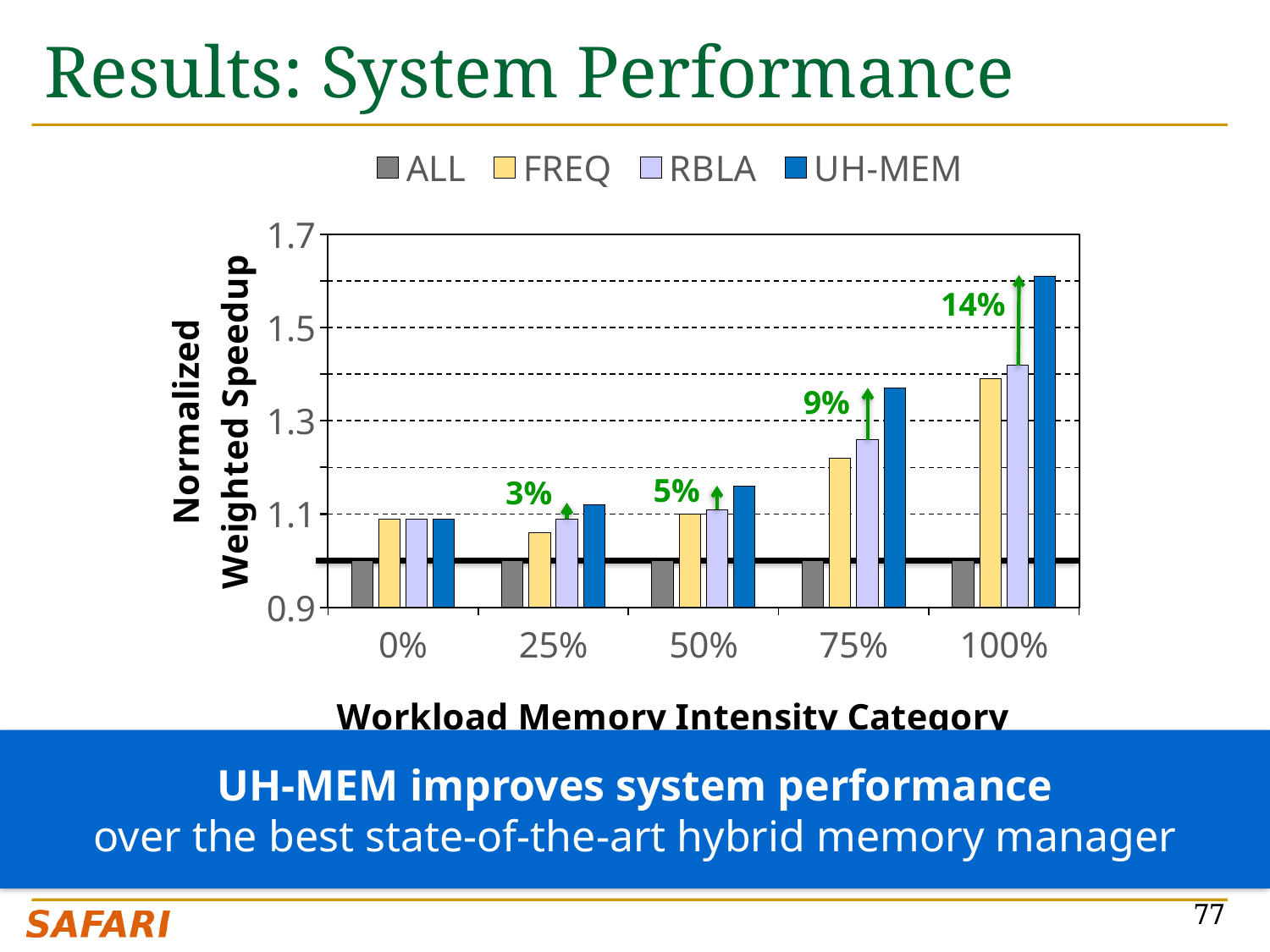
Is the UH-MEM value for the 0% category greater or less than 1.3? less How many series does the legend list? 4 Is the FREQ value for the 75% category greater or less than 1.3? less How many workload memory intensity categories are shown on the x axis? 5 Is the UH-MEM value for the 100% category greater or less than 1.5? greater Do the UH-MEM values rise or fall as the workload memory intensity category increases from 0% to 100%? rise What improvement percentage is annotated above the 100% category? 14% Which workload memory intensity category has the highest UH-MEM normalized weighted speedup? 100% What kind of chart is shown on the slide? bar chart In the 75% category, which is larger, the UH-MEM value or the FREQ value? UH-MEM What improvement percentage is annotated above the 75% category? 9% Which series has the lowest value in the 100% category? ALL